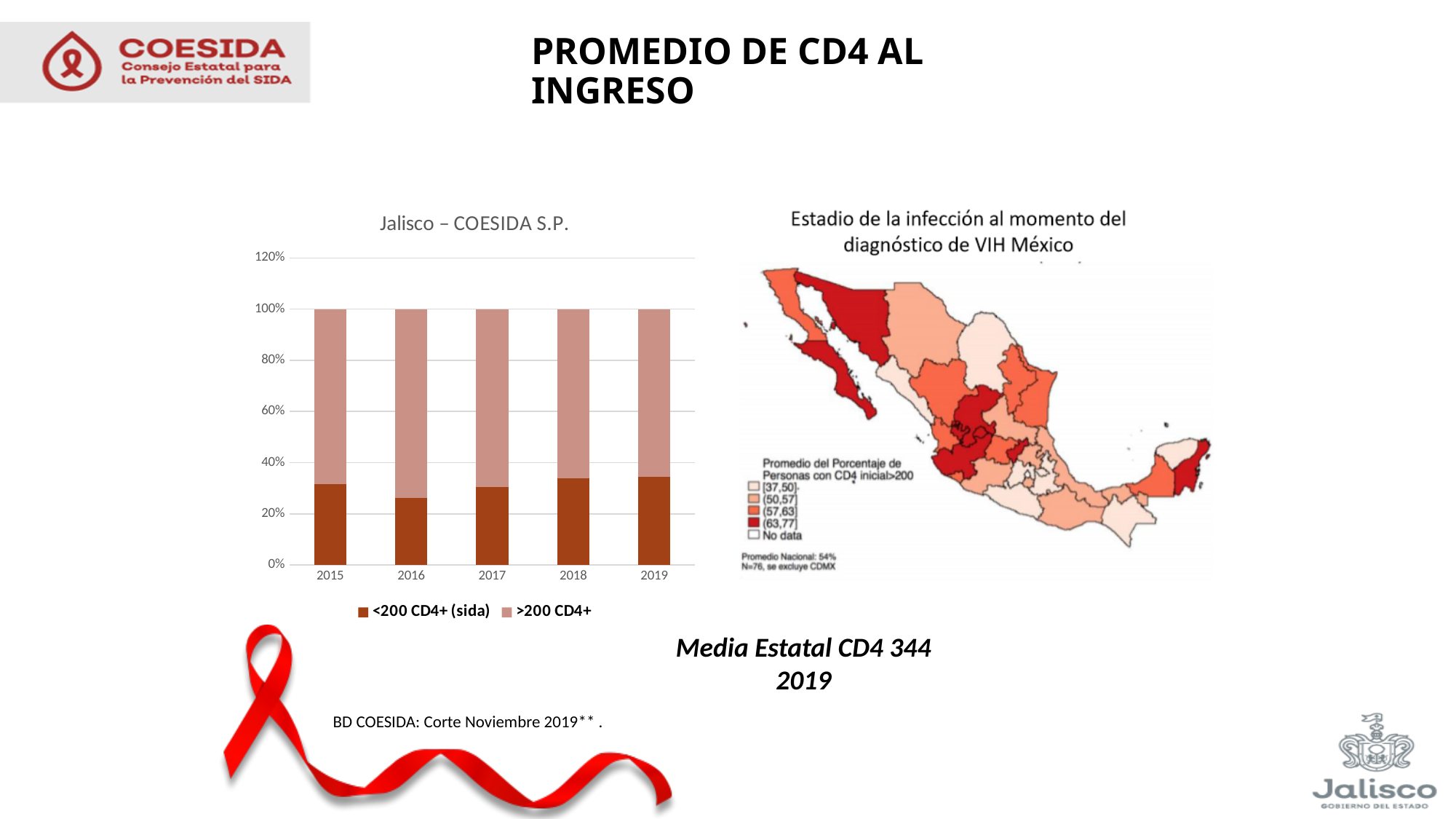
In the "Jalisco – COESIDA S.P." chart, is the "<200 CD4+ (sida)" share for 2018 greater or less than 20%? greater In the "Jalisco – COESIDA S.P." chart, which year has the lowest share of "<200 CD4+ (sida)"? 2016 How many years are shown on the x axis of the "Jalisco – COESIDA S.P." chart? 5 In the "Jalisco – COESIDA S.P." chart, which year has the larger "<200 CD4+ (sida)" share, 2016 or 2018? 2018 In the "Jalisco – COESIDA S.P." chart, which year has the larger ">200 CD4+" share, 2015 or 2016? 2016 What is the title of the bar chart on the left of the slide? Jalisco – COESIDA S.P. How many series does the legend of the "Jalisco – COESIDA S.P." chart list? 2 What type of chart is shown under the title "Jalisco – COESIDA S.P."? Stacked bar chart In the "Jalisco – COESIDA S.P." chart, is the "<200 CD4+ (sida)" share for 2016 greater or less than 30%? less What are the two legend entries of the "Jalisco – COESIDA S.P." chart? <200 CD4+ (sida) and >200 CD4+ In the "Jalisco – COESIDA S.P." chart, is the "<200 CD4+ (sida)" share for 2016 greater or less than 40%? less In the "Jalisco – COESIDA S.P." chart, what is the total height of the stacked bar for 2017? 100%